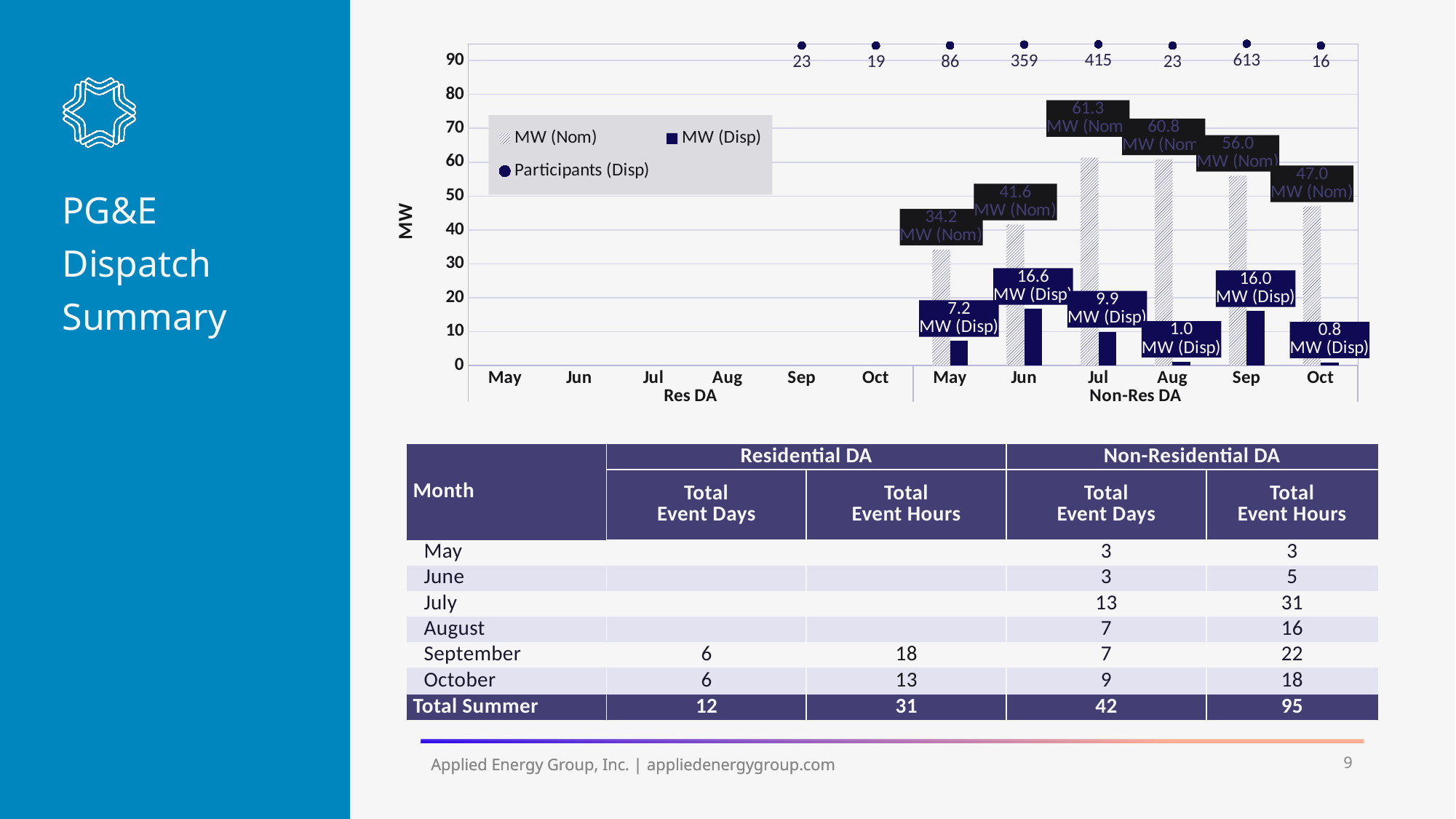
What is the MW (Nom) value for Jul in the Non-Res DA group? 61.3 Which is larger, the MW (Disp) value for Jun or for Sep in the Non-Res DA group? Jun Which Non-Res DA month has the highest MW (Nom) value? Jul How many series does the chart legend list? 3 What is the MW (Disp) value for Jun in the Non-Res DA group? 16.6 Which Non-Res DA month has the lowest MW (Disp) value? Oct How many Participants (Disp) are shown for Sep in the Non-Res DA group? 613 What is the difference between MW (Nom) and MW (Disp) for Jul in the Non-Res DA group? 51.4 Which month has the highest number of Participants (Disp)? Sep (Non-Res DA) What kind of chart is shown on the slide? bar chart What label is shown on the vertical axis of the chart? MW Is the MW (Nom) value for Aug in the Non-Res DA group greater or less than 50? greater